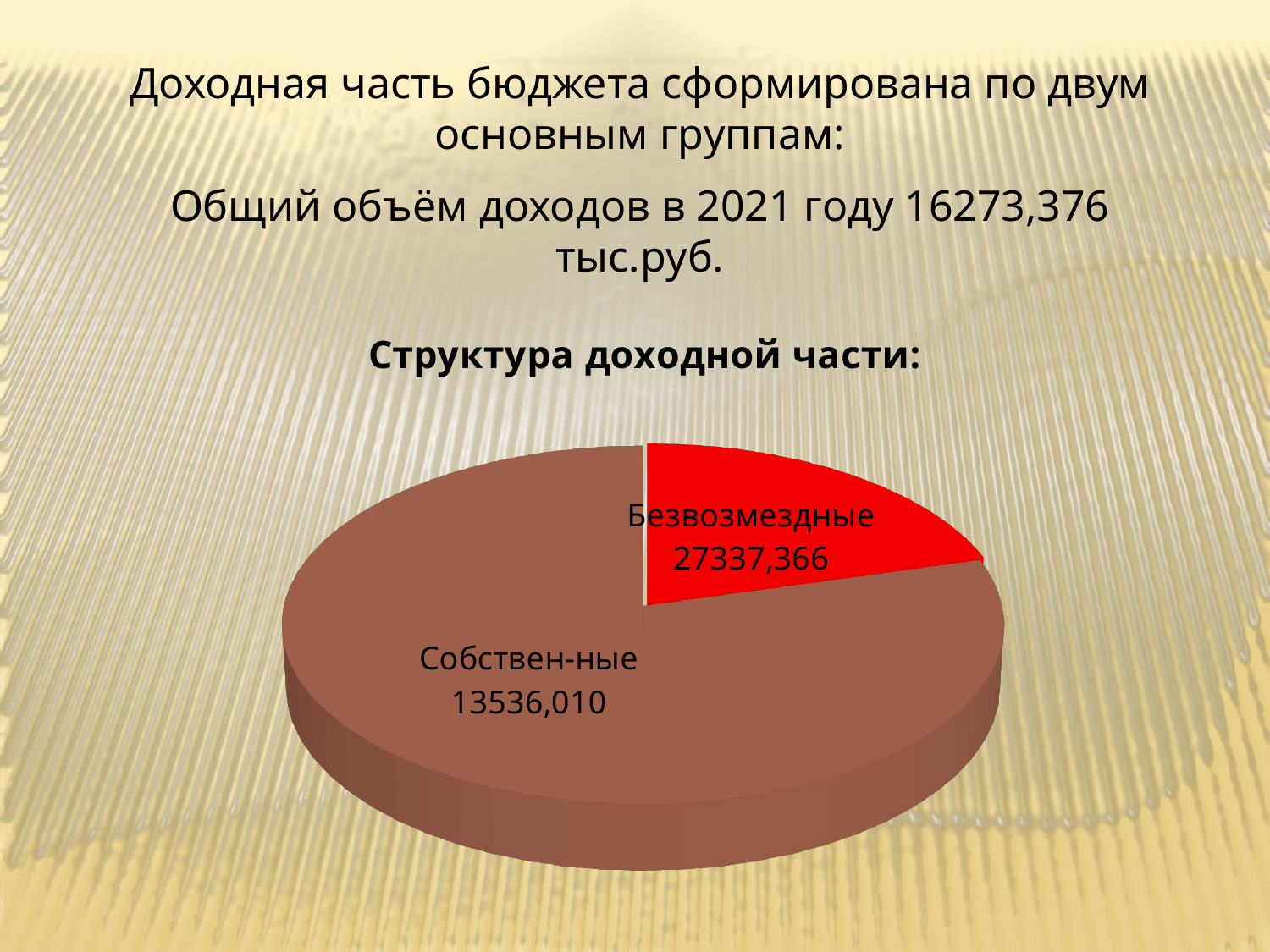
What colour is the Безвозмездные slice of the pie chart? Red What type of chart is shown on the slide? Pie chart How many slices does the pie chart have? 2 What is the difference between the printed values for Безвозмездные and Собствен-ные? 13801,356 What value is shown for the Безвозмездные slice of the pie chart? 27337,366 What value is shown for the Собствен-ные slice of the pie chart? 13536,010 What is the title of the chart on the slide? Структура доходной части: